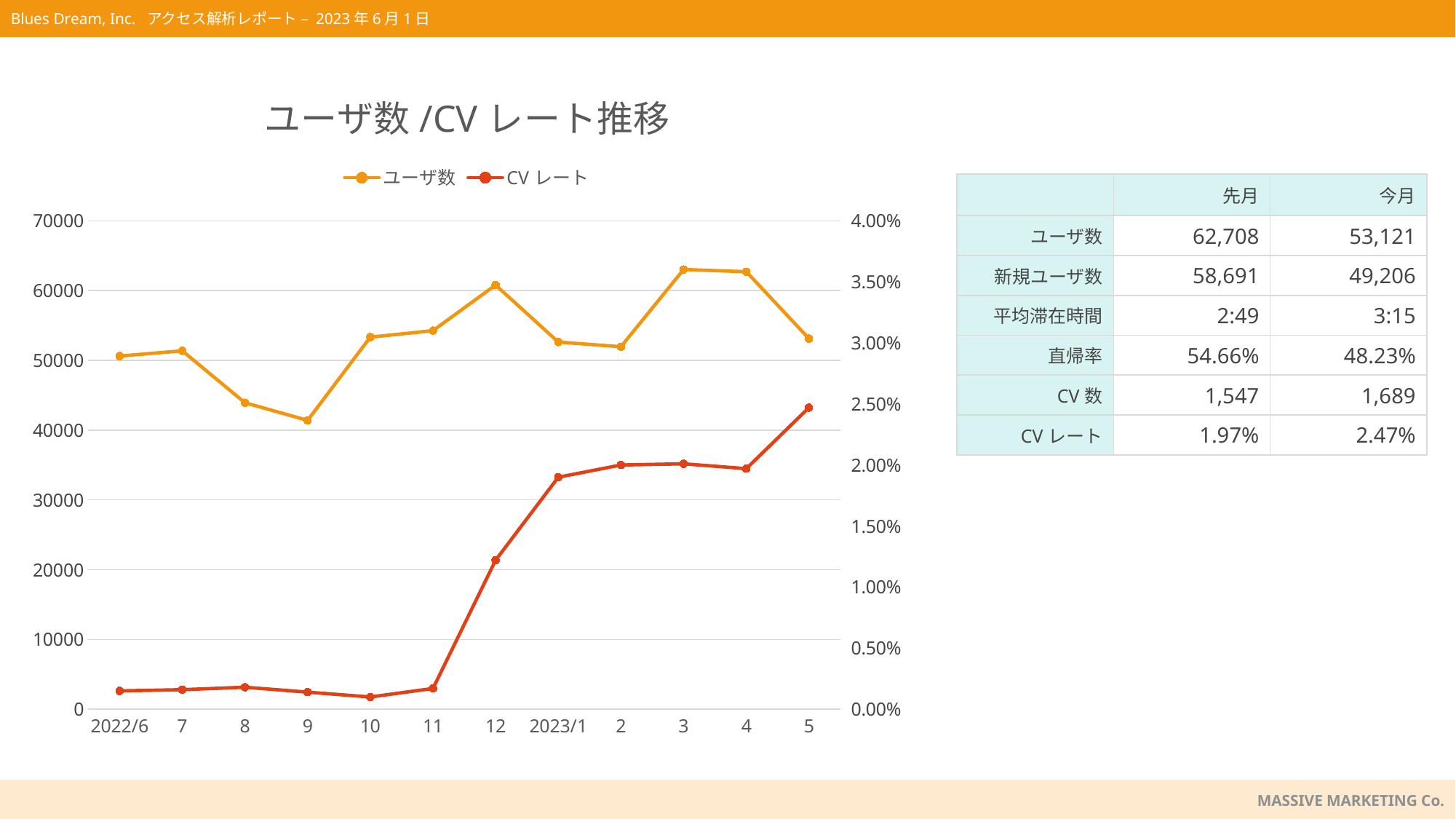
In which month is the ユーザ数 value lowest? 2022/9 How many series does the chart legend list? 2 Which month has the larger ユーザ数 value, 2022/12 or 2023/1? 2022/12 How many months are plotted along the x axis of the chart? 12 In which month is the CV レート value highest? 2023/5 Does the CV レート line generally rise or fall from 2022/6 to 2023/5? Rise Is the ユーザ数 value for 2023/3 greater or less than 60000? greater What is the title of the chart? ユーザ数 /CV レート推移 What kind of chart is shown on the slide? Line chart Which colour is used for the CV レート line in the chart? Red Is the ユーザ数 value for 2022/9 greater or less than 50000? less Is the CV レート value for 2022/10 greater or less than 0.50%? less